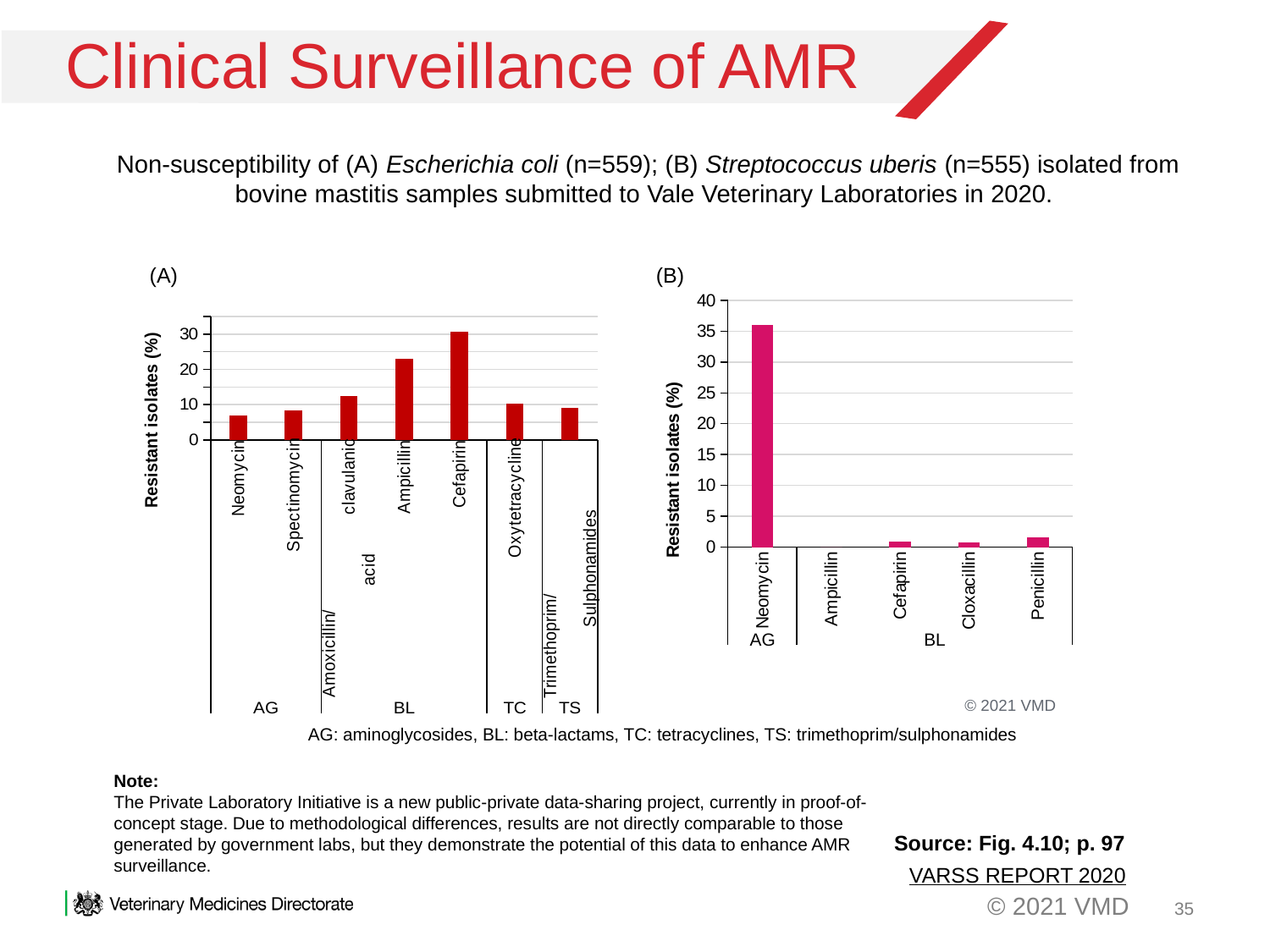
How many antimicrobials are plotted in chart (B)? 5 In chart (B), is the value for Penicillin greater or less than 5? less In chart (B), which antimicrobial has the highest percentage of resistant isolates? Neomycin How many antimicrobials are plotted in chart (A)? 7 In chart (B), which antimicrobial has the lowest percentage of resistant isolates? Ampicillin In chart (A), which antimicrobial has the highest percentage of resistant isolates? Cefapirin In chart (A), which antimicrobial has the lowest percentage of resistant isolates? Neomycin What type of chart is chart (B)? Bar chart In chart (A), is the value for Ampicillin greater or less than 20? greater In chart (A), which has a higher percentage of resistant isolates, Ampicillin or Oxytetracycline? Ampicillin